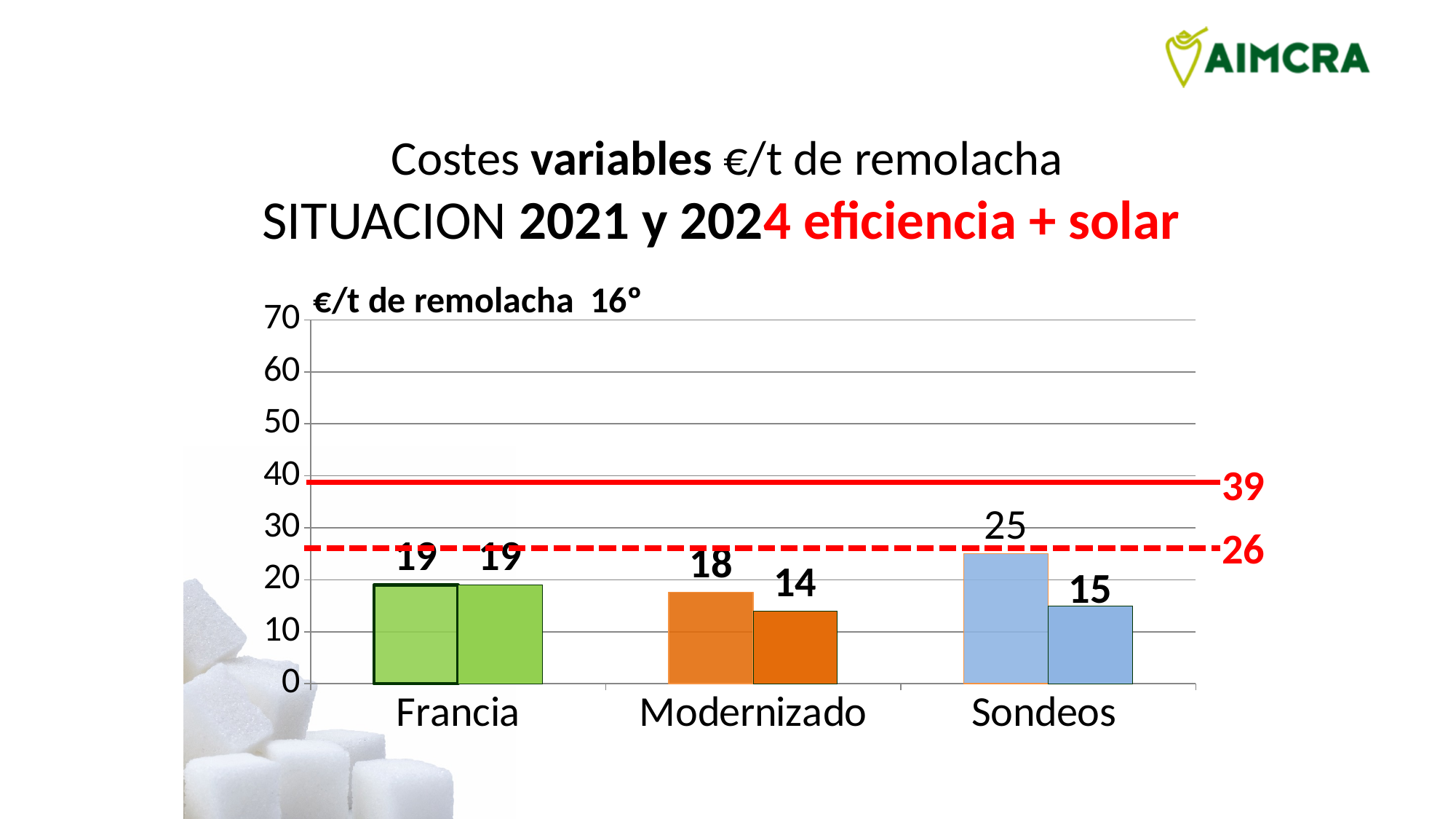
What value is labelled on the solid red horizontal line in the chart? 39 How many categories are shown on the x axis of the chart? 3 What is the value of the right bar for Modernizado? 14 What is the value of the right bar for Sondeos? 15 What type of chart is shown on the slide? bar chart Which is larger, the left bar for Sondeos or the left bar for Modernizado? Sondeos What is the value of the left bar for Francia? 19 What is the difference between the left and right bars for Modernizado? 4 Is the left bar for Sondeos greater or less than 30? less Which category has the highest single bar value in the chart? Sondeos What is the difference between the left and right bars for Sondeos? 10 What is the value of the left bar for Sondeos? 25